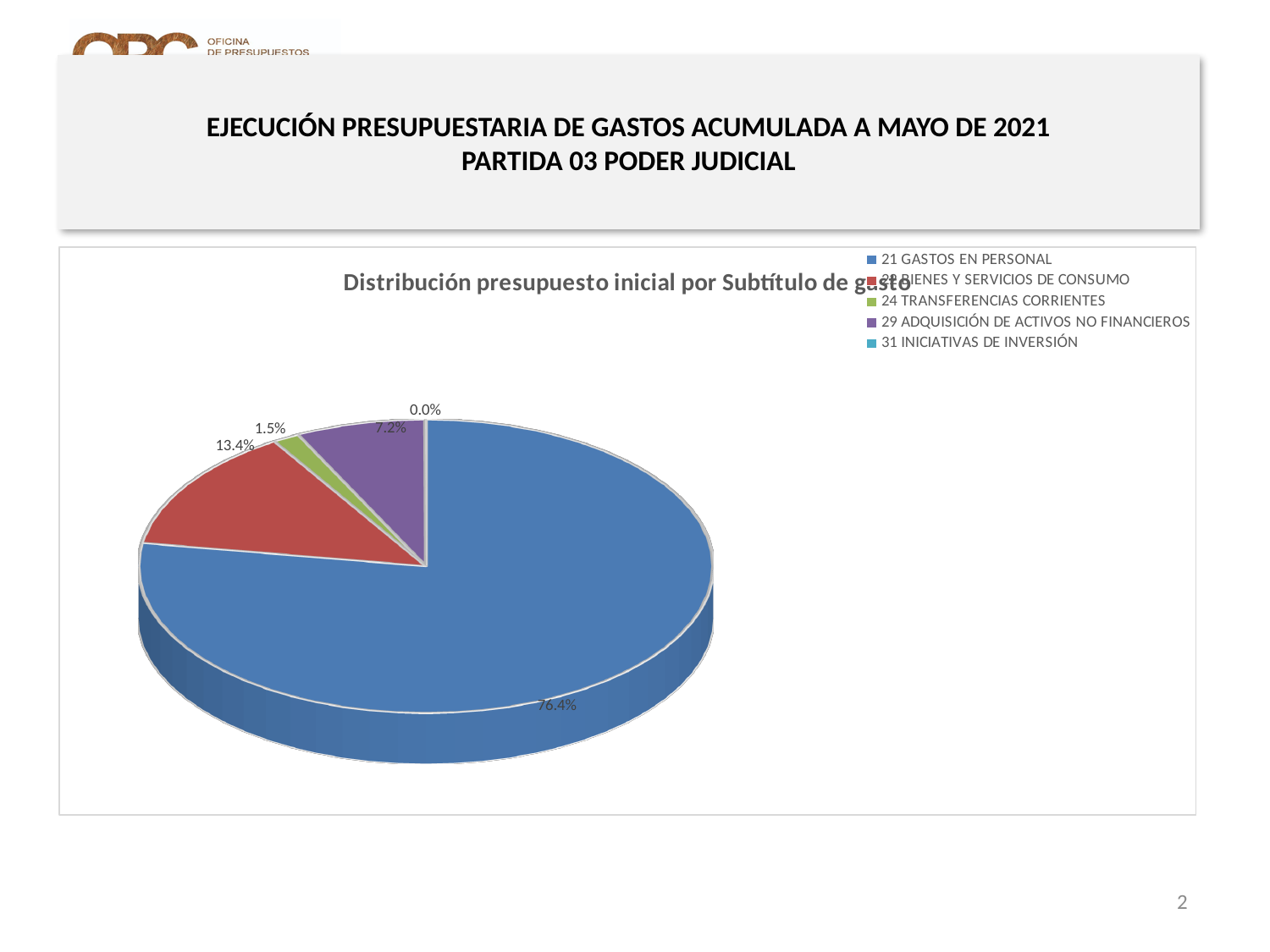
Which slice is larger, 24 TRANSFERENCIAS CORRIENTES or 29 ADQUISICIÓN DE ACTIVOS NO FINANCIEROS? 29 ADQUISICIÓN DE ACTIVOS NO FINANCIEROS What share of the pie does 29 ADQUISICIÓN DE ACTIVOS NO FINANCIEROS represent? 7.2% How many categories does the legend list? 5 What share of the pie does 31 INICIATIVAS DE INVERSIÓN represent? 0.0% What is the chart's title? Distribución presupuesto inicial por Subtítulo de gasto What share of the pie does 21 GASTOS EN PERSONAL represent? 76.4% What kind of chart is shown on the slide? Pie chart What colour is the slice for 21 GASTOS EN PERSONAL? Blue Which category has the largest slice of the pie? 21 GASTOS EN PERSONAL Which category has the smallest slice of the pie? 31 INICIATIVAS DE INVERSIÓN What is the difference in percentage points between the 21 GASTOS EN PERSONAL slice and the 29 ADQUISICIÓN DE ACTIVOS NO FINANCIEROS slice? 69.2 percentage points